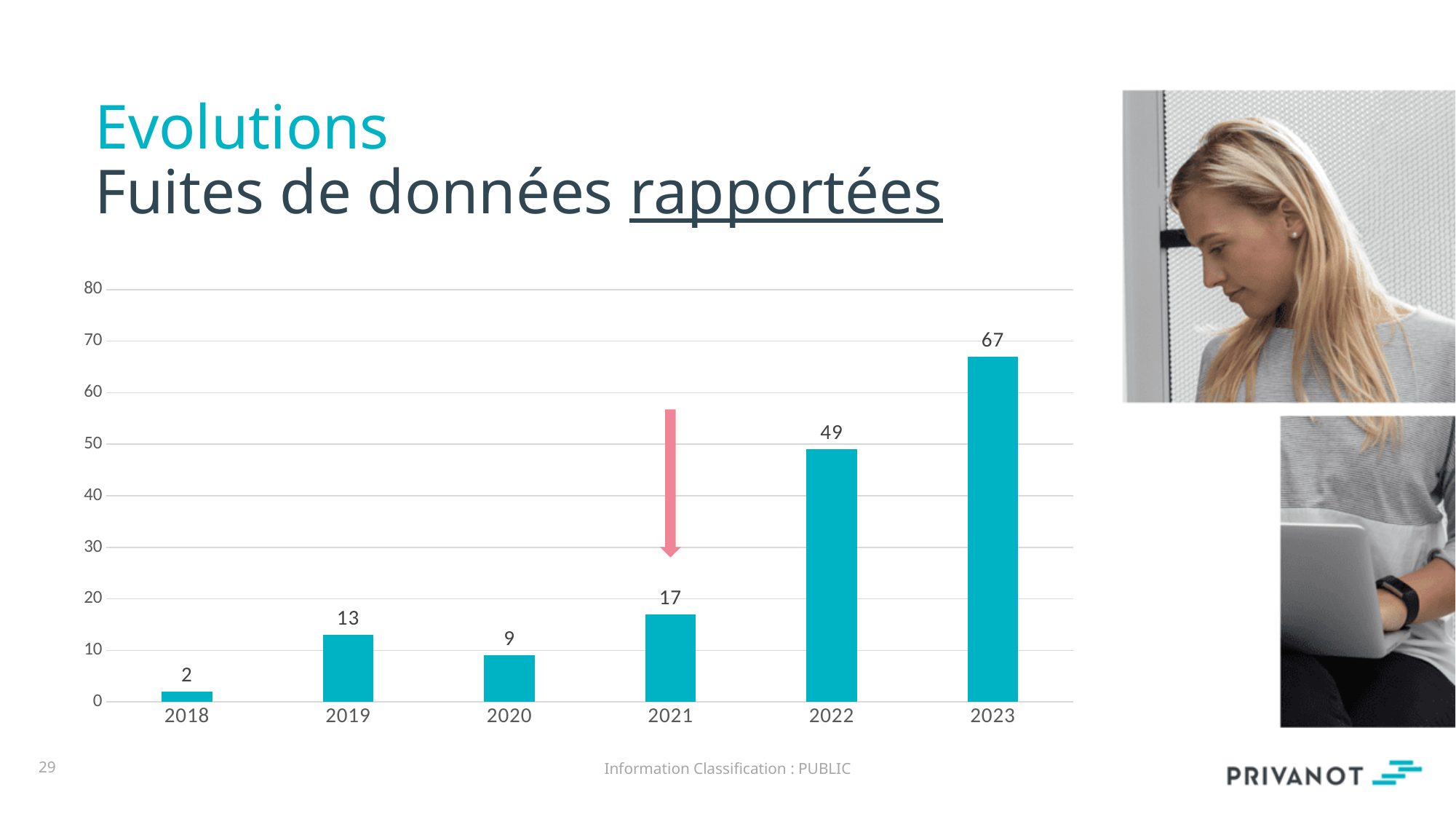
What is the difference between the values for 2023 and 2022? 18 Which is larger, the value for 2019 or the value for 2020? 2019 What is the value for 2021? 17 What is the value for 2018? 2 Which year does the pink arrow point to? 2021 How many years are shown on the x axis? 6 Which year has the highest value? 2023 Is the value for 2022 greater or less than 40? greater What is the value for 2023? 67 What kind of chart is shown on the slide? bar chart What is the difference between the values for 2019 and 2020? 4 Which year has the lowest value? 2018